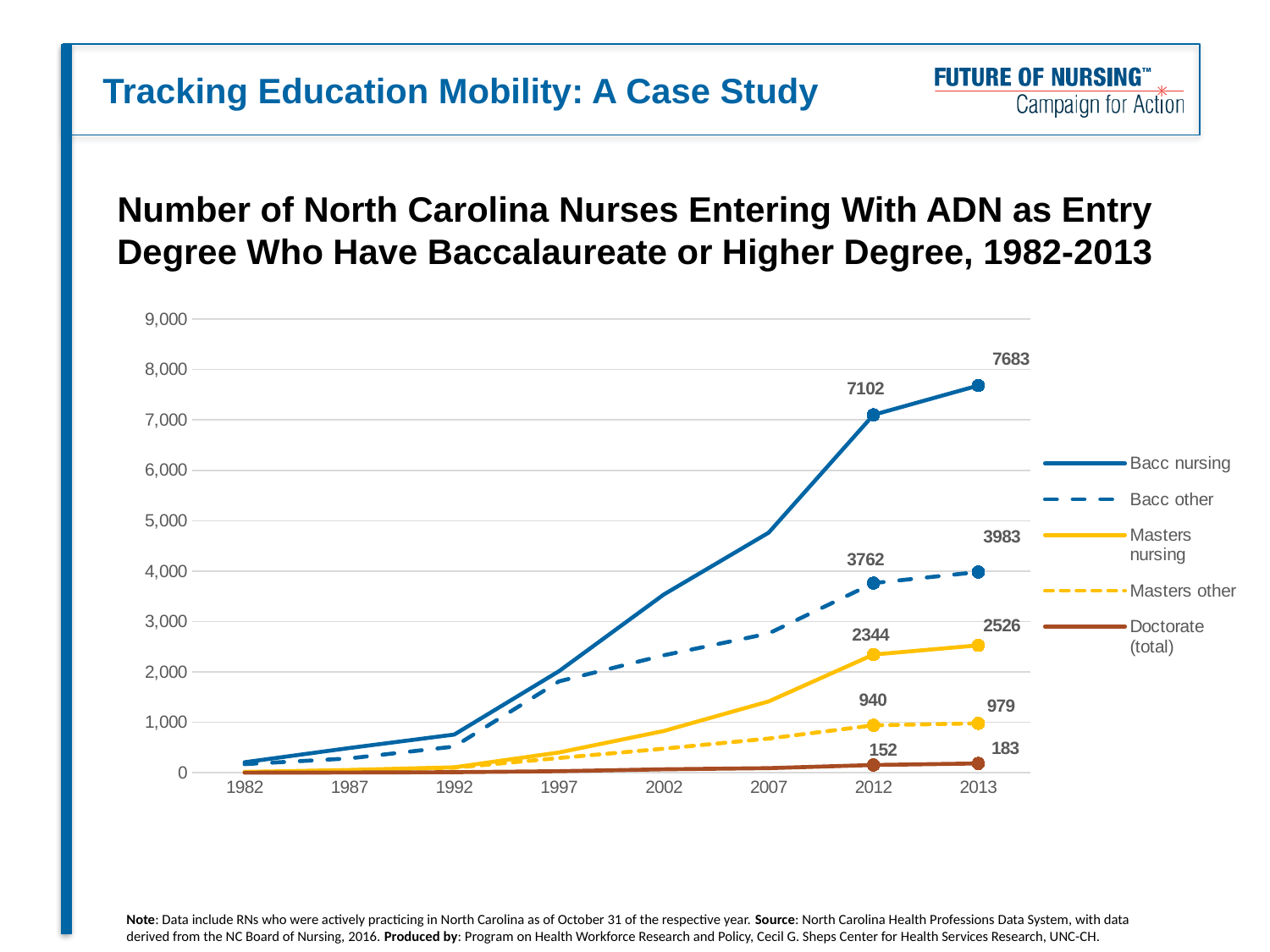
Is the value for Bacc nursing in 2007 greater or less than 4,000? greater What type of chart is shown on the slide? Line chart Which series has the highest value in 2013? Bacc nursing How many years are labelled on the x axis? 8 What is the value for Doctorate (total) in 2012? 152 What is the value for Bacc nursing in 2013? 7683 What is the value for Bacc other in 2012? 3762 What is the difference between the Bacc nursing values for 2013 and 2012? 581 Which is larger in 2013: Masters other or Doctorate (total)? Masters other How many series does the legend list? 5 What is the value for Masters nursing in 2013? 2526 Which series has the lowest value in 2012? Doctorate (total)